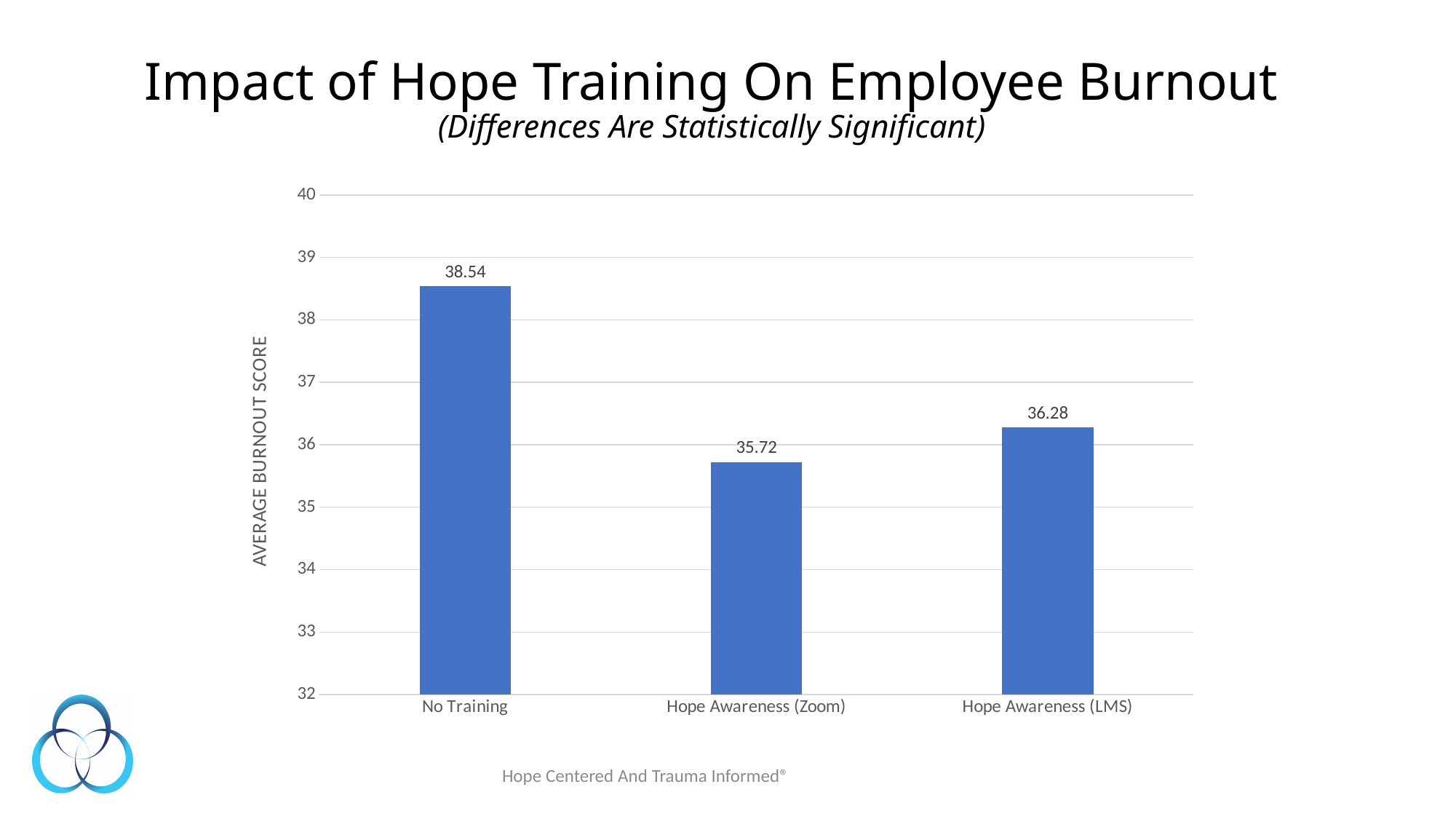
Which has a higher average burnout score, Hope Awareness (Zoom) or Hope Awareness (LMS)? Hope Awareness (LMS) Which category has the highest average burnout score? No Training What is the average burnout score for Hope Awareness (LMS)? 36.28 What is the average burnout score for Hope Awareness (Zoom)? 35.72 What kind of chart is shown on the slide? bar chart What is the average burnout score for No Training? 38.54 What is the label of the vertical axis? AVERAGE BURNOUT SCORE Is the value for No Training greater or less than 38? greater What is the difference between the average burnout score for Hope Awareness (LMS) and for Hope Awareness (Zoom)? 0.56 How many categories are shown on the x axis? 3 Which category has the lowest average burnout score? Hope Awareness (Zoom) What is the difference between the average burnout score for No Training and for Hope Awareness (Zoom)? 2.82